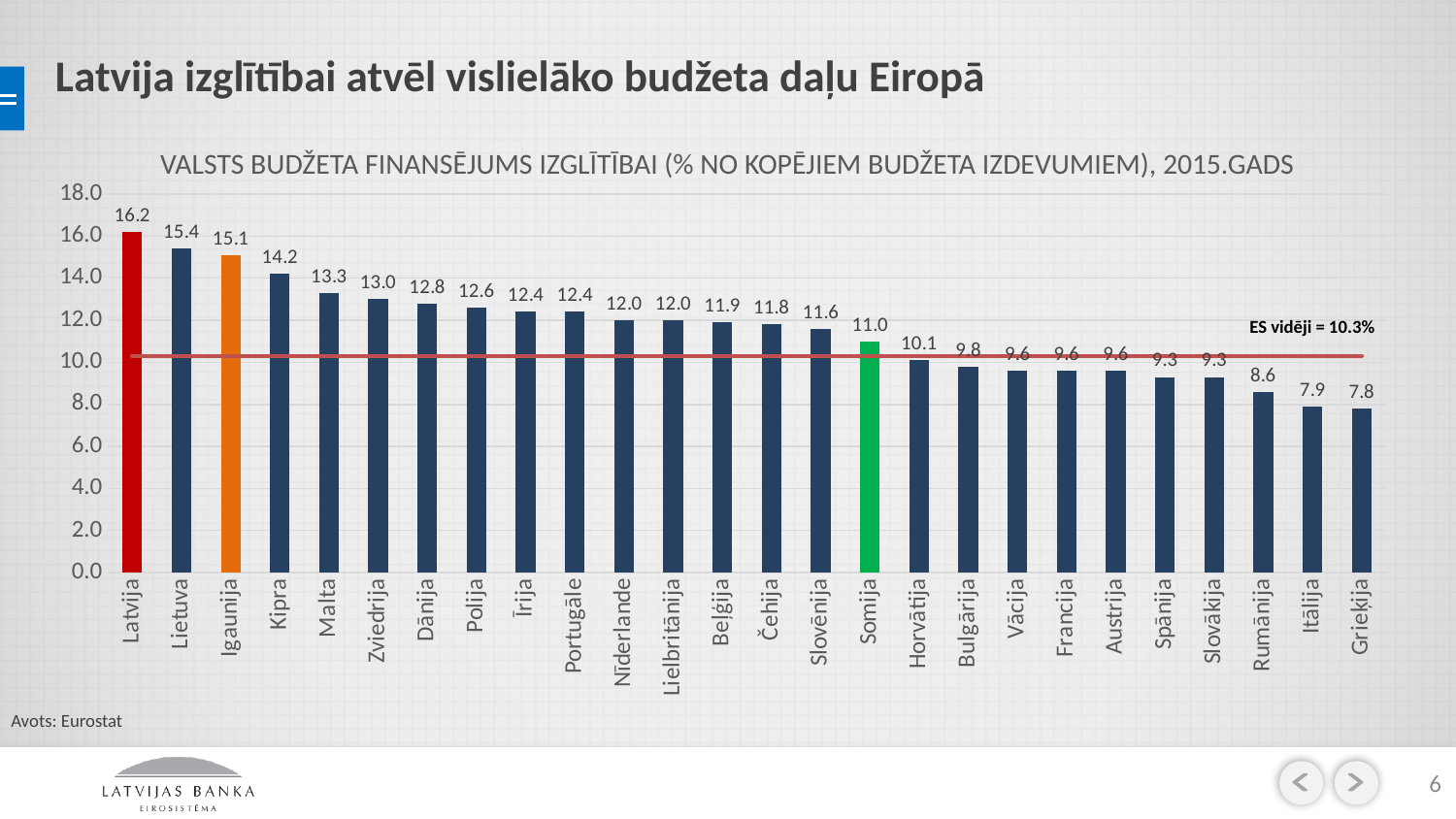
What is the difference between the values for Kipra and Horvātija? 4.1 What is the value for Rumānija? 8.6 What is the EU average value shown by the horizontal line on the chart? 10.3% Is the value for Bulgārija greater or less than 10.0? less Which country has the highest value? Latvija What is the difference between the values for Latvija and Lietuva? 0.8 What is the value for Somija? 11.0 What kind of chart is shown on the slide? bar chart Which is larger, the value for Malta or the value for Polija? Malta How many countries are shown on the chart? 26 What is the value for Latvija? 16.2 Which country has the lowest value? Grieķija